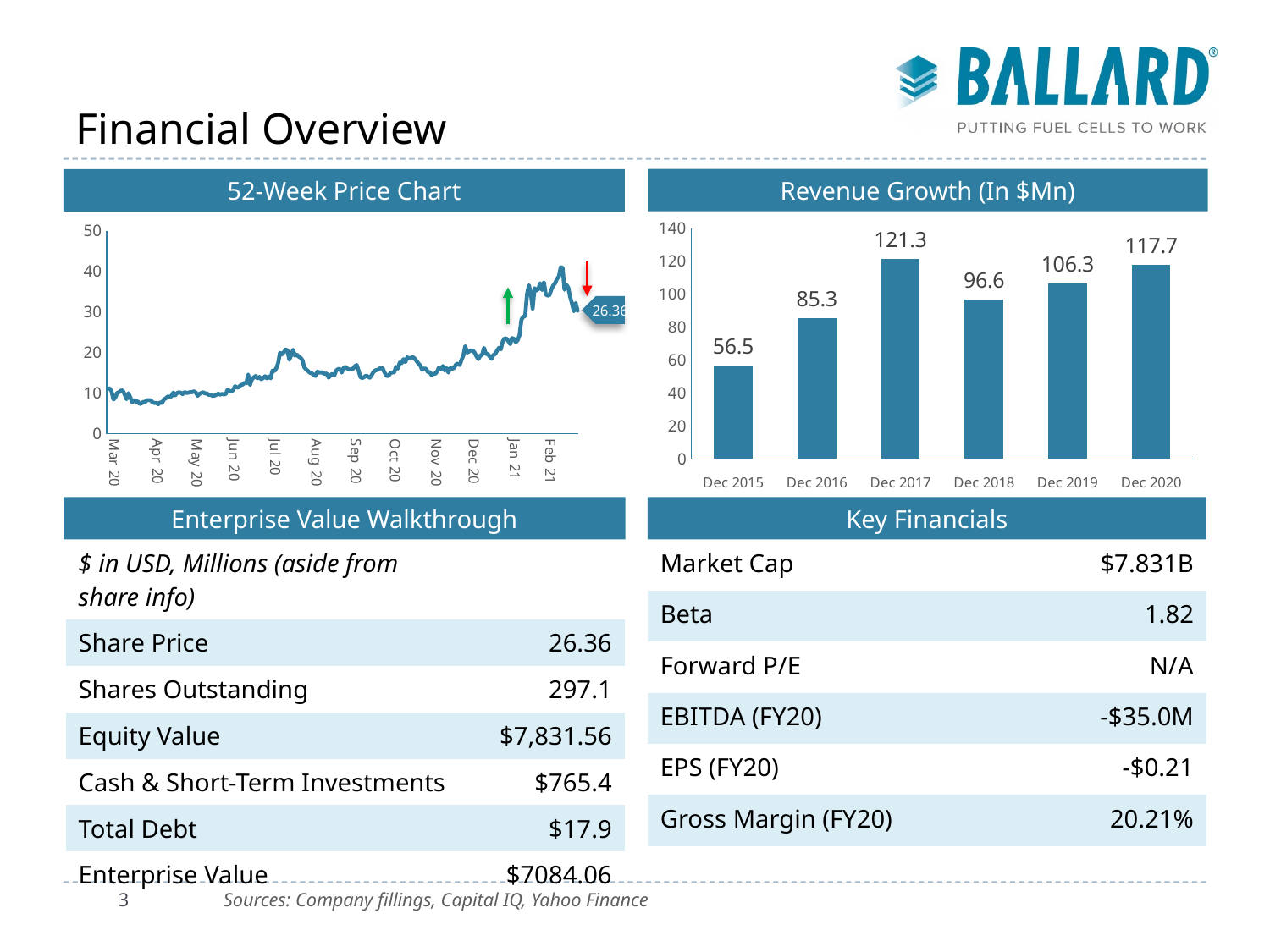
In the 52-Week Price Chart, is the value at Jul 20 greater or less than 30? less In the 52-Week Price Chart, what is the last labelled price value shown at the end of the line? 26.36 In the Revenue Growth (In $Mn) chart, how many bars are plotted? 6 What kind of chart is the Revenue Growth (In $Mn) chart? Bar chart In the Revenue Growth (In $Mn) chart, which is larger, the value for Dec 2019 or Dec 2020? Dec 2020 In the Revenue Growth (In $Mn) chart, what is the value for Dec 2020? 117.7 In the Revenue Growth (In $Mn) chart, which year has the highest revenue? Dec 2017 In the Revenue Growth (In $Mn) chart, what is the value for Dec 2017? 121.3 In the Revenue Growth (In $Mn) chart, what is the value for Dec 2015? 56.5 In the Revenue Growth (In $Mn) chart, what is the difference between the Dec 2017 and Dec 2018 values? 24.7 What kind of chart is the 52-Week Price Chart? Line chart In the Revenue Growth (In $Mn) chart, which year has the lowest revenue? Dec 2015